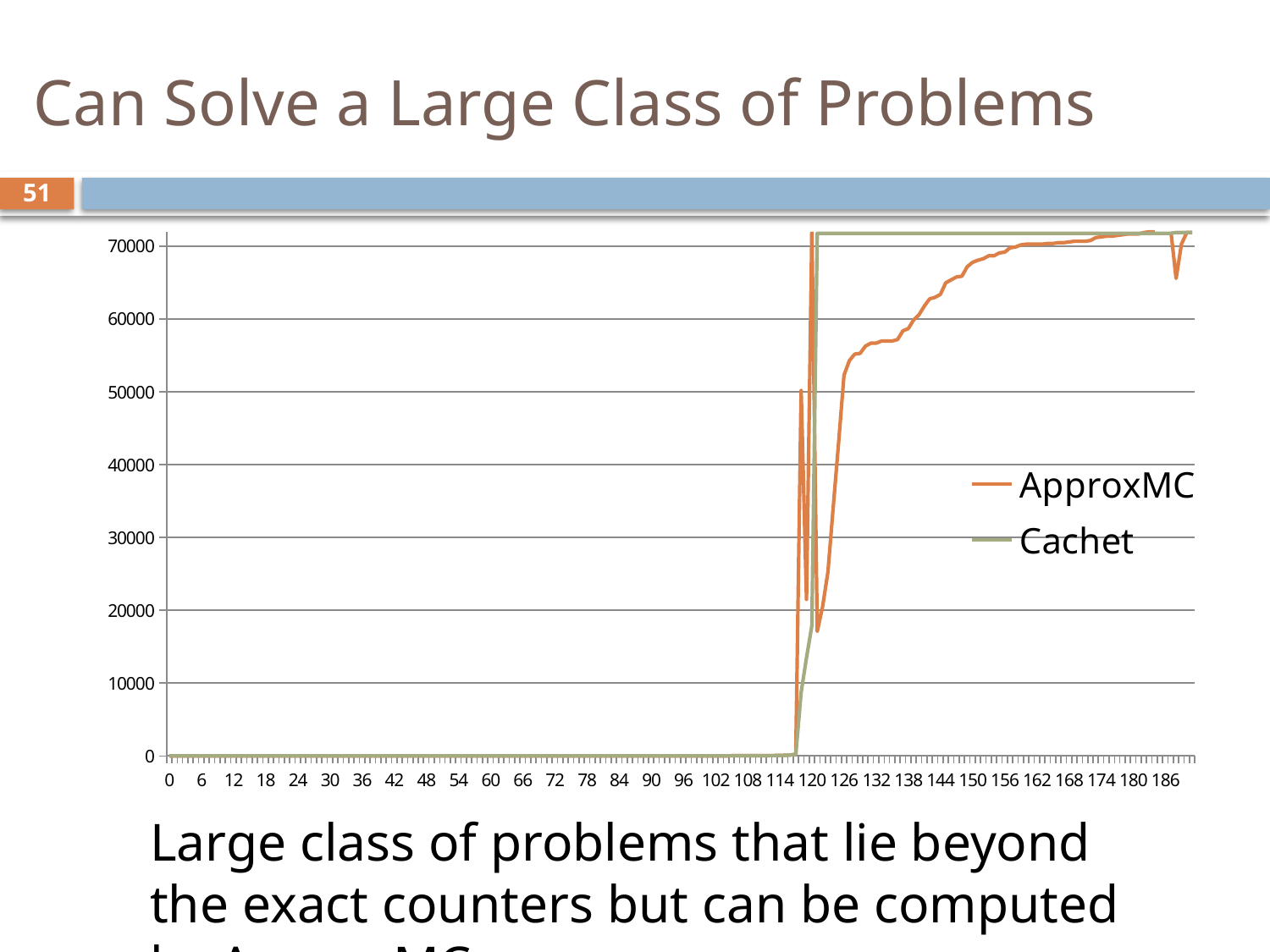
Is the Cachet value at x = 150 greater or less than 60000? greater Is the ApproxMC value at x = 60 greater or less than 10000? less At x = 150, which series has the higher value, ApproxMC or Cachet? Cachet What is the highest value labelled on the chart's y axis? 70000 How many series does the chart's legend list? 2 What are the two series named in the chart's legend? ApproxMC and Cachet What colour is the ApproxMC line in the chart? orange Is the Cachet value at x = 90 greater or less than 10000? less Does the ApproxMC line rise or fall between x = 126 and x = 174? rise What kind of chart is shown on the slide? line chart